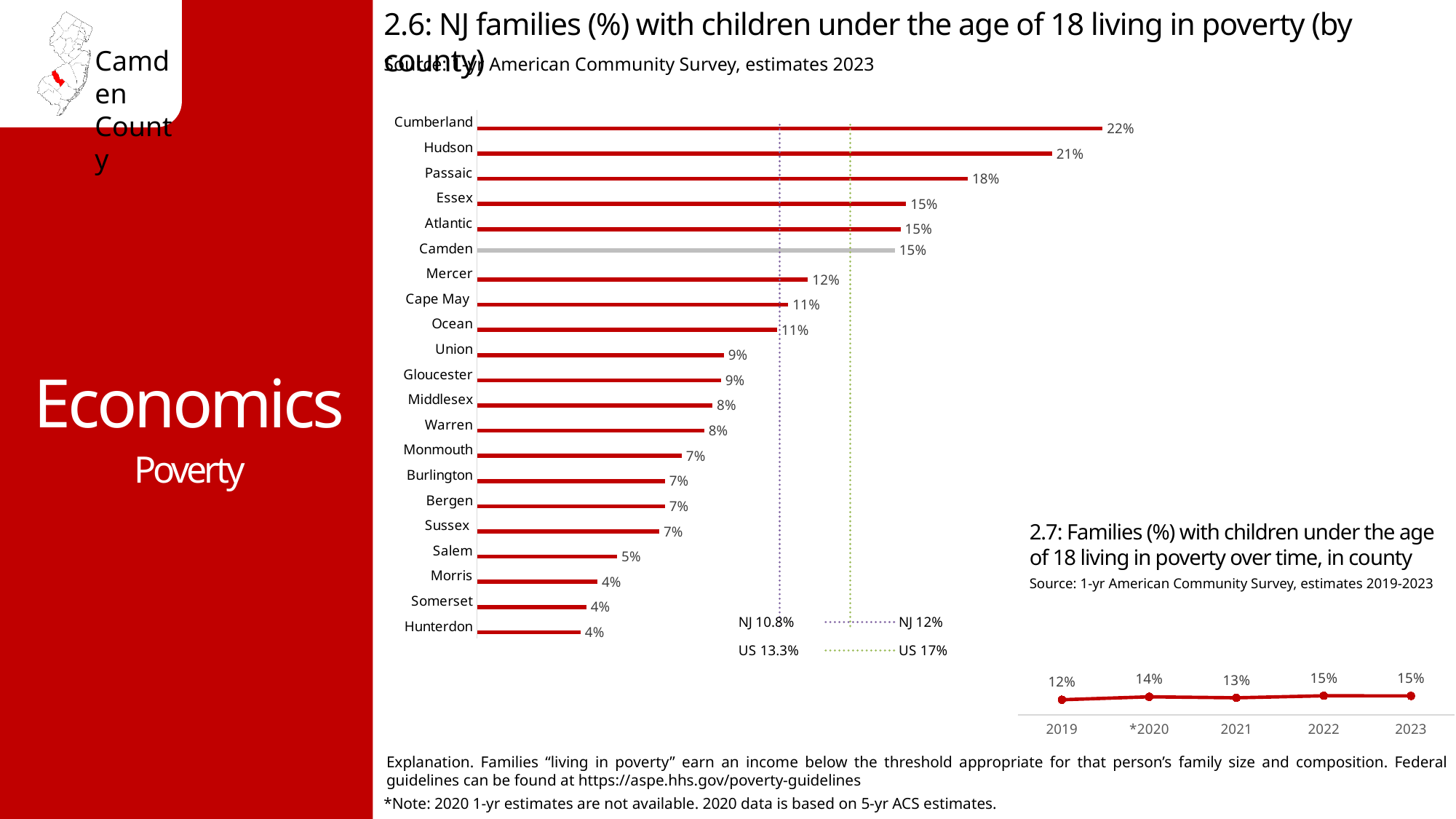
In chart 2.7, what is the value for 2019? 12% What kind of chart is chart 2.6? Bar chart In chart 2.6, what is the difference between the values for Cumberland and Hudson? 1% In chart 2.6, what is the value for Camden? 15% What kind of chart is chart 2.7? Line chart In chart 2.7, how many years are plotted? 5 In chart 2.6, which is larger, the value for Mercer or the value for Salem? Mercer In chart 2.6, what is the difference between the values for Camden and Hunterdon? 11% In chart 2.6, how many counties are plotted? 21 In chart 2.6, what is the value for Passaic? 18% In chart 2.7, what is the value for 2022? 15% In chart 2.6, which county has the highest value? Cumberland